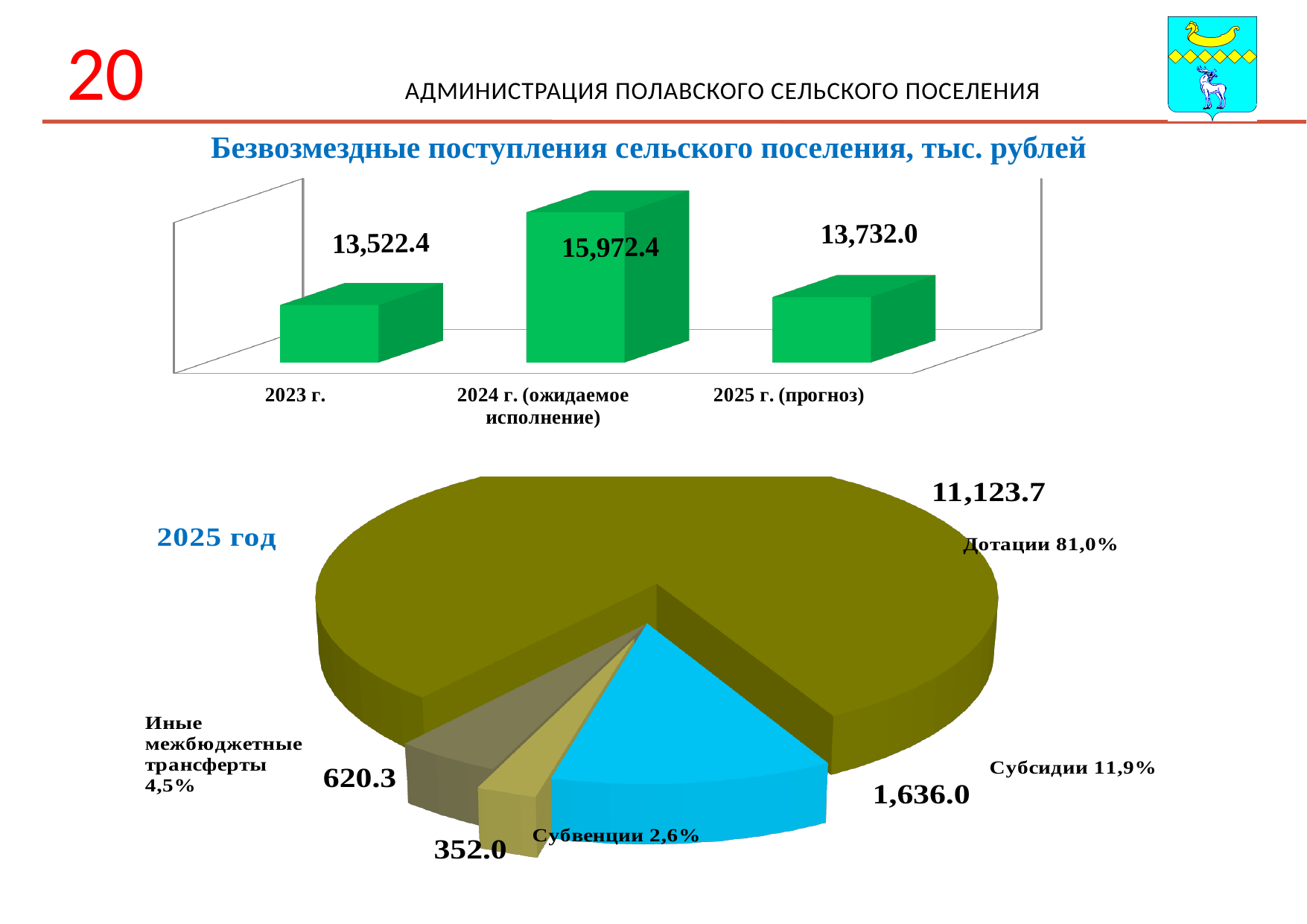
In the top bar chart, what is the value for 2024 г. (ожидаемое исполнение)? 15,972.4 In the bottom pie chart (2025 год), which slice is the smallest? Субвенции In the top bar chart, how many categories are shown? 3 In the top bar chart, which year has the lowest value? 2023 г. What type of chart is the top chart on the slide? Bar chart In the bottom pie chart (2025 год), what is the value for Дотации? 11,123.7 In the top bar chart, which year has the highest value? 2024 г. (ожидаемое исполнение) In the bottom pie chart (2025 год), what share does Субсидии have? 11,9% In the top bar chart, what is the difference between the 2024 г. (ожидаемое исполнение) value and the 2023 г. value? 2,450.0 In the bottom pie chart (2025 год), which is larger: Иные межбюджетные трансферты or Субвенции? Иные межбюджетные трансферты In the top bar chart, what is the value for 2023 г.? 13,522.4 In the top bar chart, what is the value for 2025 г. (прогноз)? 13,732.0